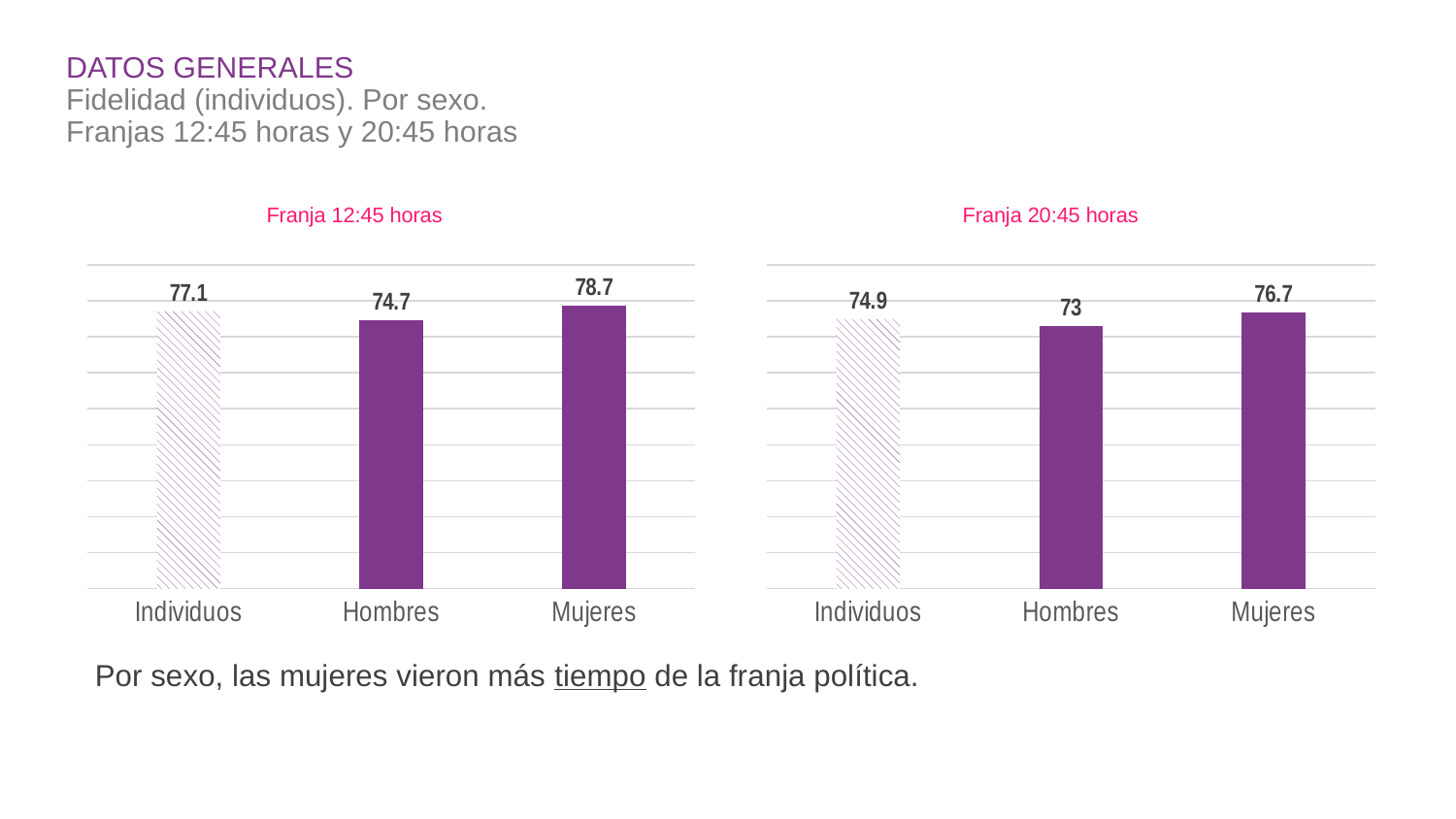
In the 'Franja 12:45 horas' chart, what is the value for Hombres? 74.7 In the 'Franja 20:45 horas' chart, which bar is drawn with a hatched pattern rather than solid fill? Individuos In the 'Franja 20:45 horas' chart, what is the value for Hombres? 73 In the 'Franja 20:45 horas' chart, which category has the lowest value? Hombres In the 'Franja 20:45 horas' chart, what is the value for Individuos? 74.9 How many categories are shown in the 'Franja 20:45 horas' chart? 3 What kind of chart is the 'Franja 12:45 horas' chart? Bar chart In the 'Franja 12:45 horas' chart, which category has the highest value? Mujeres In the 'Franja 20:45 horas' chart, what is the difference between the values for Mujeres and Individuos? 1.8 In the 'Franja 12:45 horas' chart, what is the difference between the values for Mujeres and Hombres? 4 In the 'Franja 12:45 horas' chart, what is the value for Mujeres? 78.7 In the 'Franja 12:45 horas' chart, which is larger, the value for Individuos or the value for Hombres? Individuos